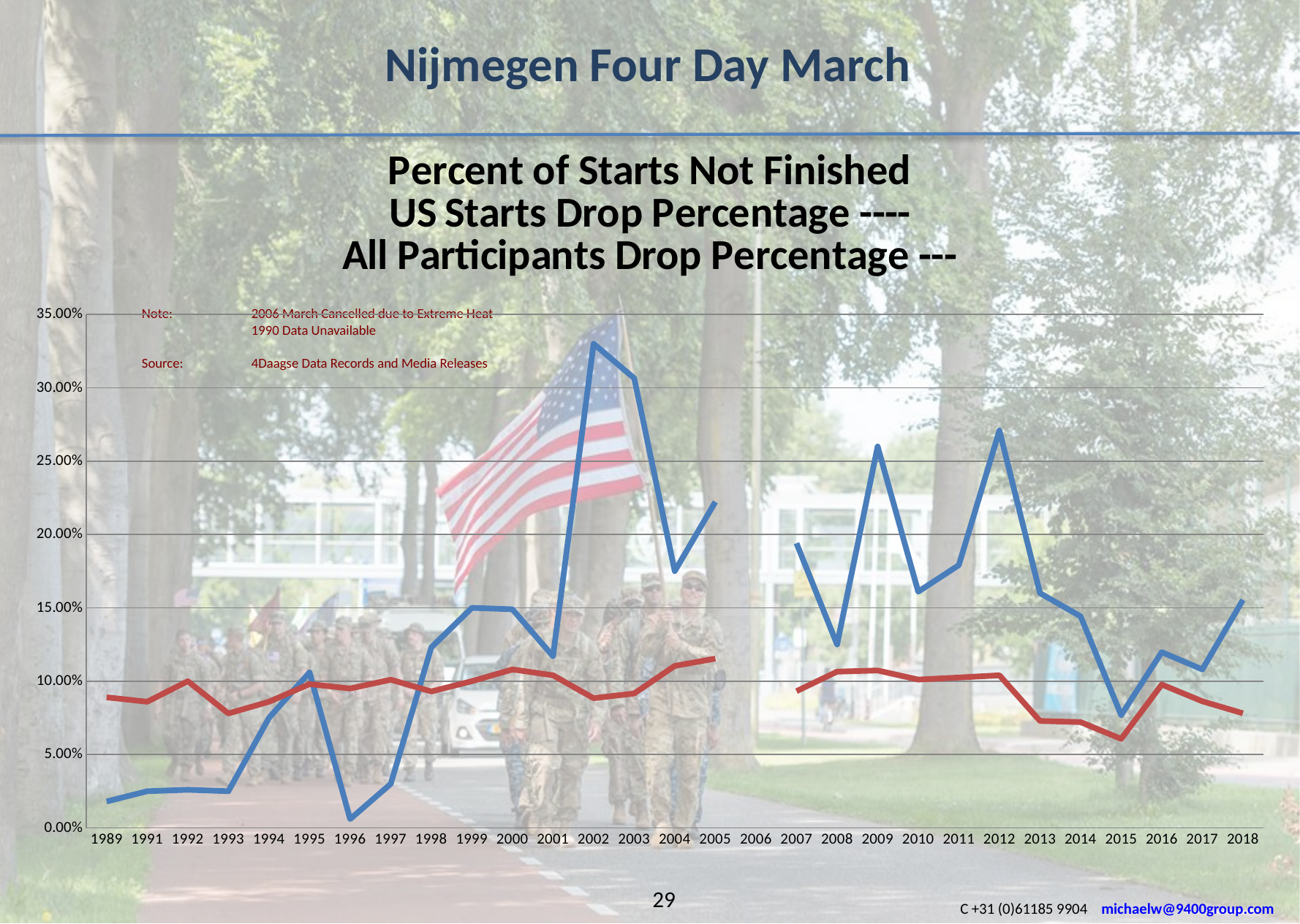
Is the US Starts Drop Percentage for 2002 greater or less than 30.00%? greater In which year does the US Starts Drop Percentage line reach its lowest value? 1996 Is the All Participants Drop Percentage for 2015 greater or less than 10.00%? less Does the US Starts Drop Percentage rise or fall from 2012 to 2015? fall How many years are labelled on the x axis of the chart? 29 In 1989, which is larger: the US Starts Drop Percentage or the All Participants Drop Percentage? All Participants Drop Percentage According to the note on the chart, why was the 2006 march cancelled? Extreme Heat What kind of chart is shown on the slide? line chart Is the US Starts Drop Percentage for 1996 greater or less than 5.00%? less In which year is the All Participants Drop Percentage line at its lowest? 2015 In which year does the US Starts Drop Percentage line reach its highest value? 2002